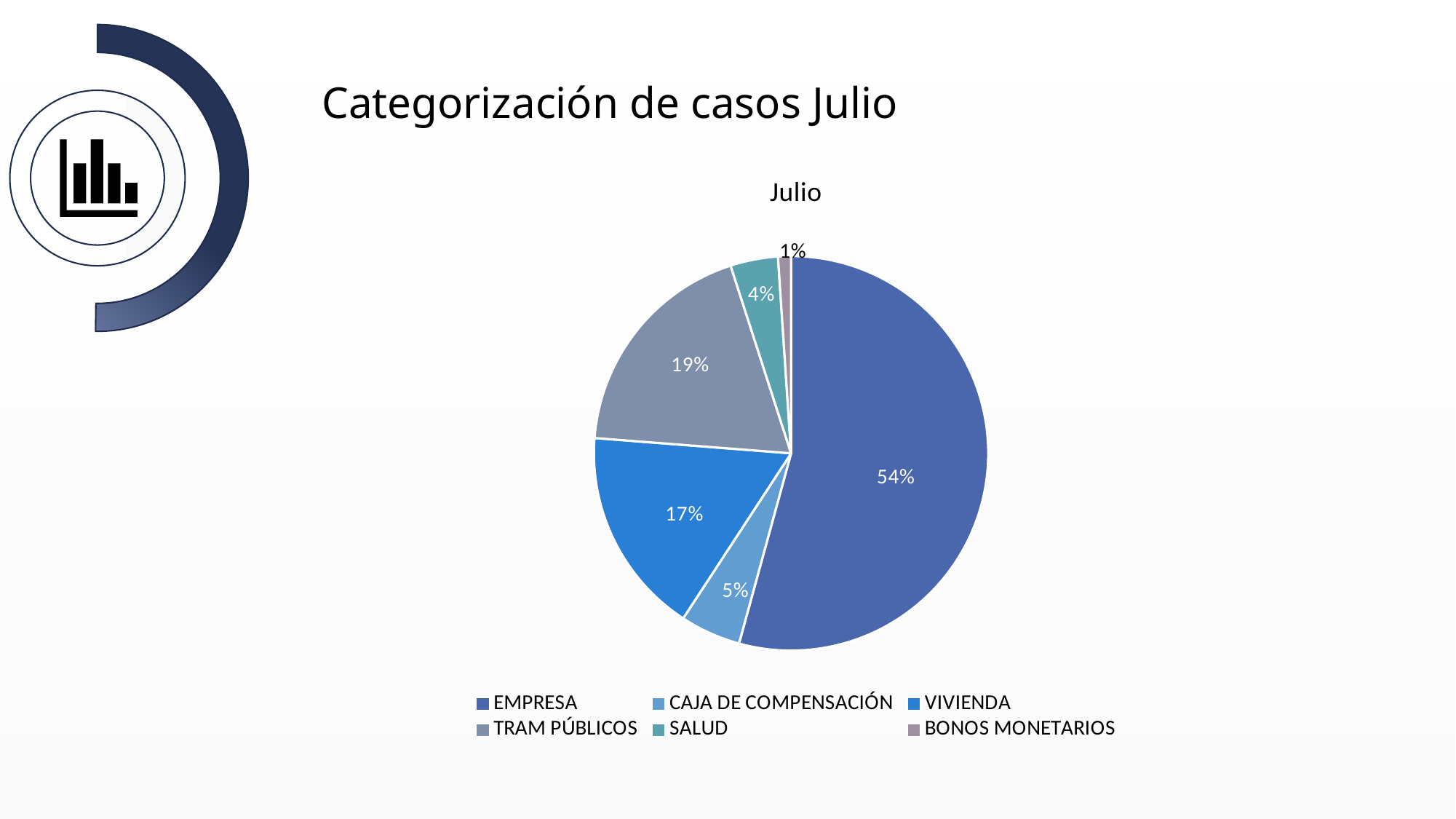
What share of the pie does VIVIENDA have? 17% What share of the pie does EMPRESA have? 54% What kind of chart is shown on the slide? pie chart What share of the pie does TRAM PÚBLICOS have? 19% What is the difference in percentage points between EMPRESA and VIVIENDA? 37 Which category has the largest slice? EMPRESA How many categories does the legend list? 6 Which category has the smallest slice? BONOS MONETARIOS What is the chart's title? Julio